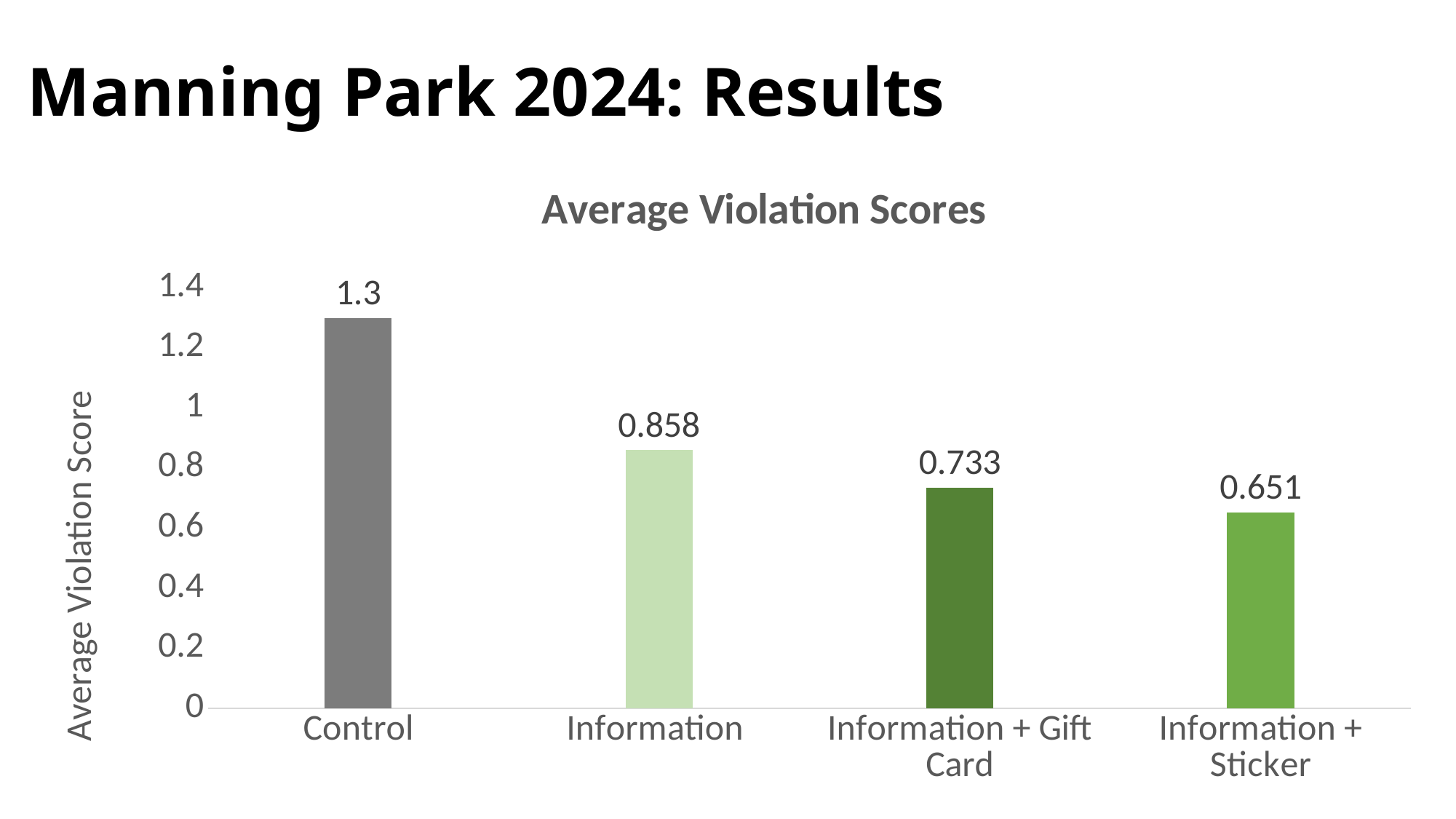
What is the average violation score for the Information group? 0.858 Is the value for Information + Gift Card greater or less than 0.8? less Which category has the lowest average violation score? Information + Sticker What is the title of the chart? Average Violation Scores What is the difference between the Control score and the Information + Sticker score? 0.649 Which has a higher average violation score, Information or Information + Gift Card? Information What kind of chart is shown on the slide? Bar chart How many categories are shown on the chart? 4 What is the average violation score for the Control group? 1.3 What is the average violation score for Information + Sticker? 0.651 What is the average violation score for Information + Gift Card? 0.733 Which category has the highest average violation score? Control